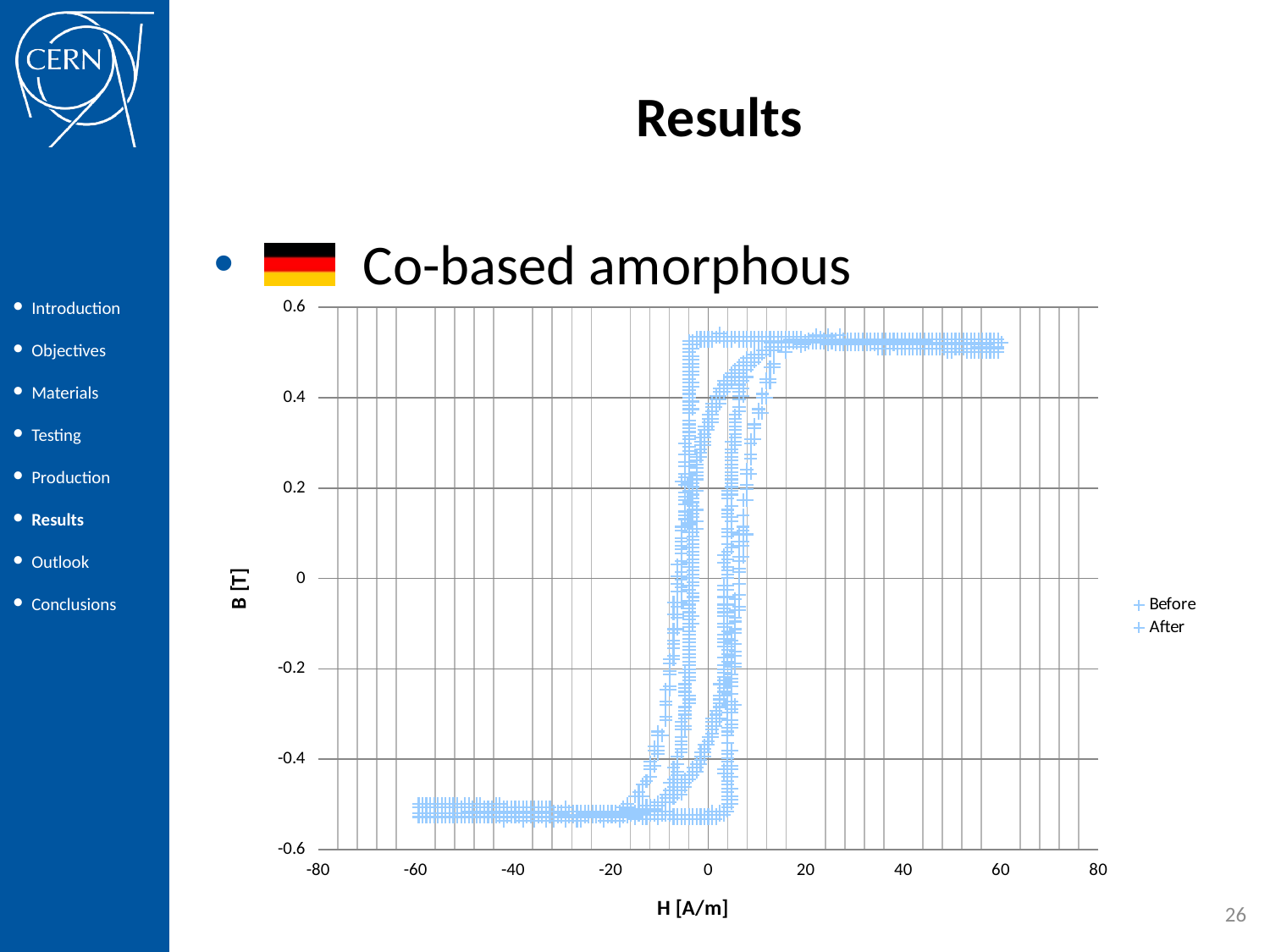
What are the two series named in the chart legend? Before and After Is the value of B at H = -40 A/m greater or less than -0.2? less Is the value of B at H = 40 A/m greater or less than 0.2? greater Is the highest B value plotted greater or less than 0.6? less What is the label of the x axis of the chart? H [A/m] As H increases from -80 to 80 A/m, does B generally rise or fall? rise Which has the larger B value: H = 60 A/m or H = -60 A/m? H = 60 A/m What kind of chart is shown on the slide? scatter chart How many tick labels are shown on the x axis? 9 How many series does the chart legend list? 2